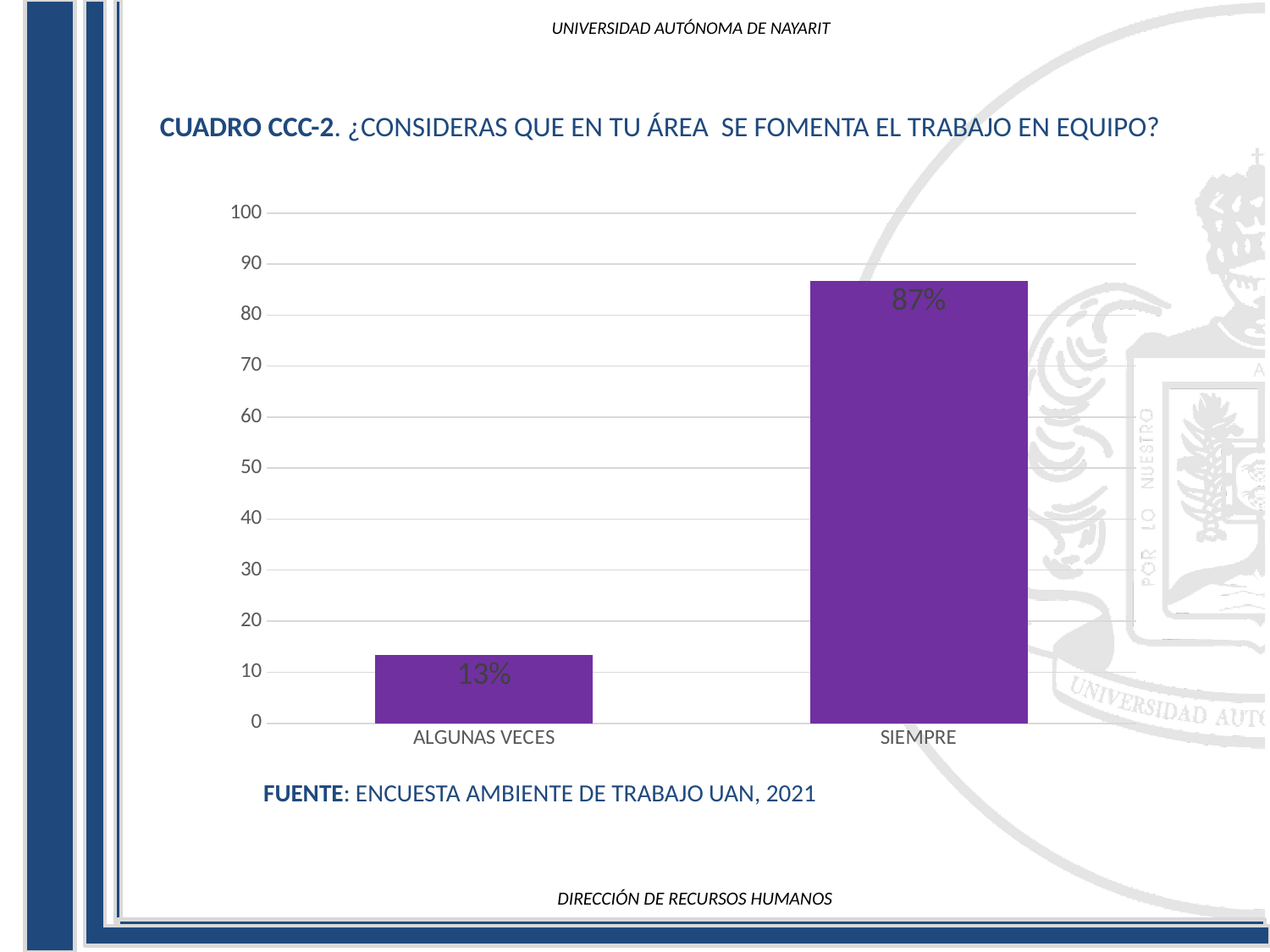
What is the value for ALGUNAS VECES? 13% Which is larger, the value for ALGUNAS VECES or the value for SIEMPRE? SIEMPRE What is the source cited below the chart? ENCUESTA AMBIENTE DE TRABAJO UAN, 2021 What kind of chart is shown on the slide? bar chart Is the value for SIEMPRE greater or less than 80? greater What is the value for SIEMPRE? 87% Is the value for ALGUNAS VECES greater or less than 20? less Which category has the highest value? SIEMPRE What is the difference between the values for SIEMPRE and ALGUNAS VECES? 74% What colour are the bars in the chart? purple How many categories are shown on the x axis? 2 Which category has the lowest value? ALGUNAS VECES